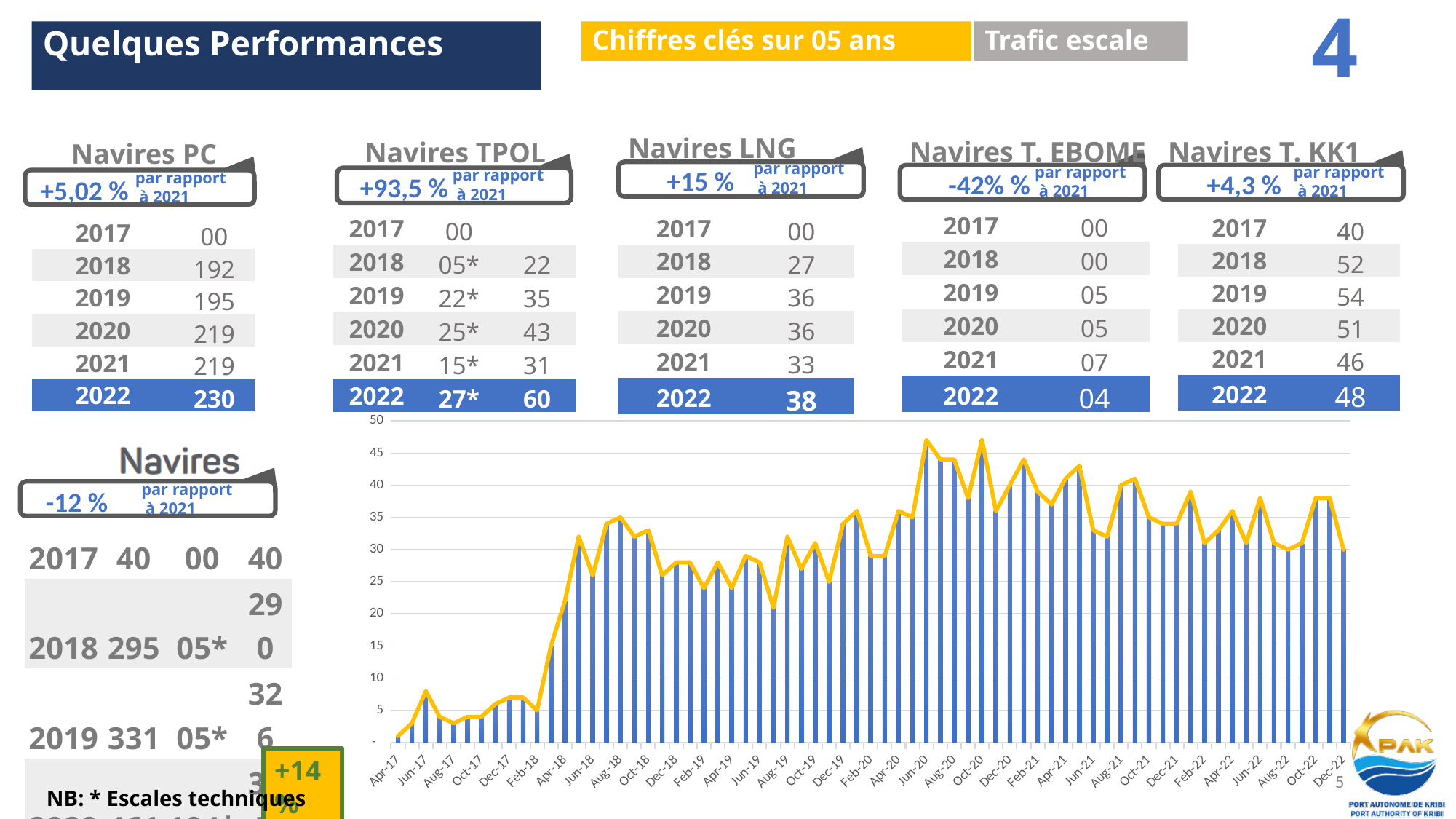
In the monthly chart, is the value for Aug-18 greater or less than 30? greater What is the highest tick value shown on the vertical axis of the monthly chart? 50 What kind of chart is shown at the bottom right of the slide? bar chart with a line overlay In the monthly chart, do the values generally rise or fall between Feb-18 and Jun-18? rise In the monthly chart, is the value for Feb-18 greater or less than 10? less In the monthly chart, which is larger, the value for Oct-22 or the value for Dec-22? Oct-22 In the monthly chart, is the value for Dec-22 greater or less than 35? less In the monthly chart, which is larger, the value for Feb-18 or the value for Jun-18? Jun-18 What colour are the bars in the monthly chart? blue In the monthly chart, which month has the lowest value? Apr-17